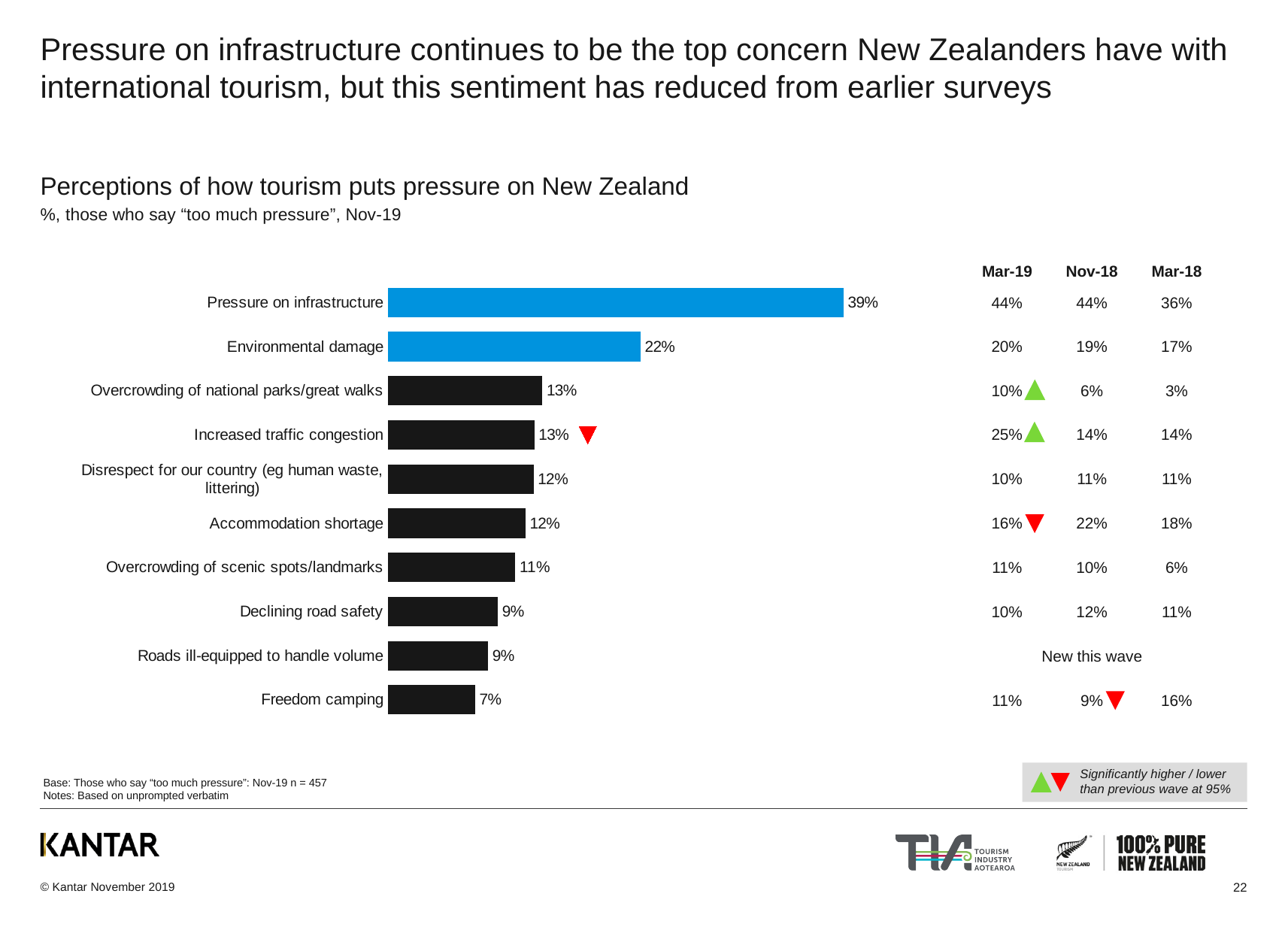
What is the Nov-19 value for Environmental damage? 22% What colour are the bars for the top two categories, Pressure on infrastructure and Environmental damage? Blue Which has a larger Nov-19 value, Environmental damage or Accommodation shortage? Environmental damage What percentage of respondents cited Pressure on infrastructure in Nov-19? 39% Which category has the lowest Nov-19 value? Freedom camping What was the Mar-19 value for Pressure on infrastructure shown in the table beside the chart? 44% What is the Nov-19 value for Accommodation shortage? 12% How many categories are plotted in the bar chart? 10 What kind of chart is shown on the slide? Bar chart Which category has the highest Nov-19 value? Pressure on infrastructure How many percentage points higher is Pressure on infrastructure than Environmental damage in Nov-19? 17 percentage points What is the Nov-19 value for Freedom camping? 7%